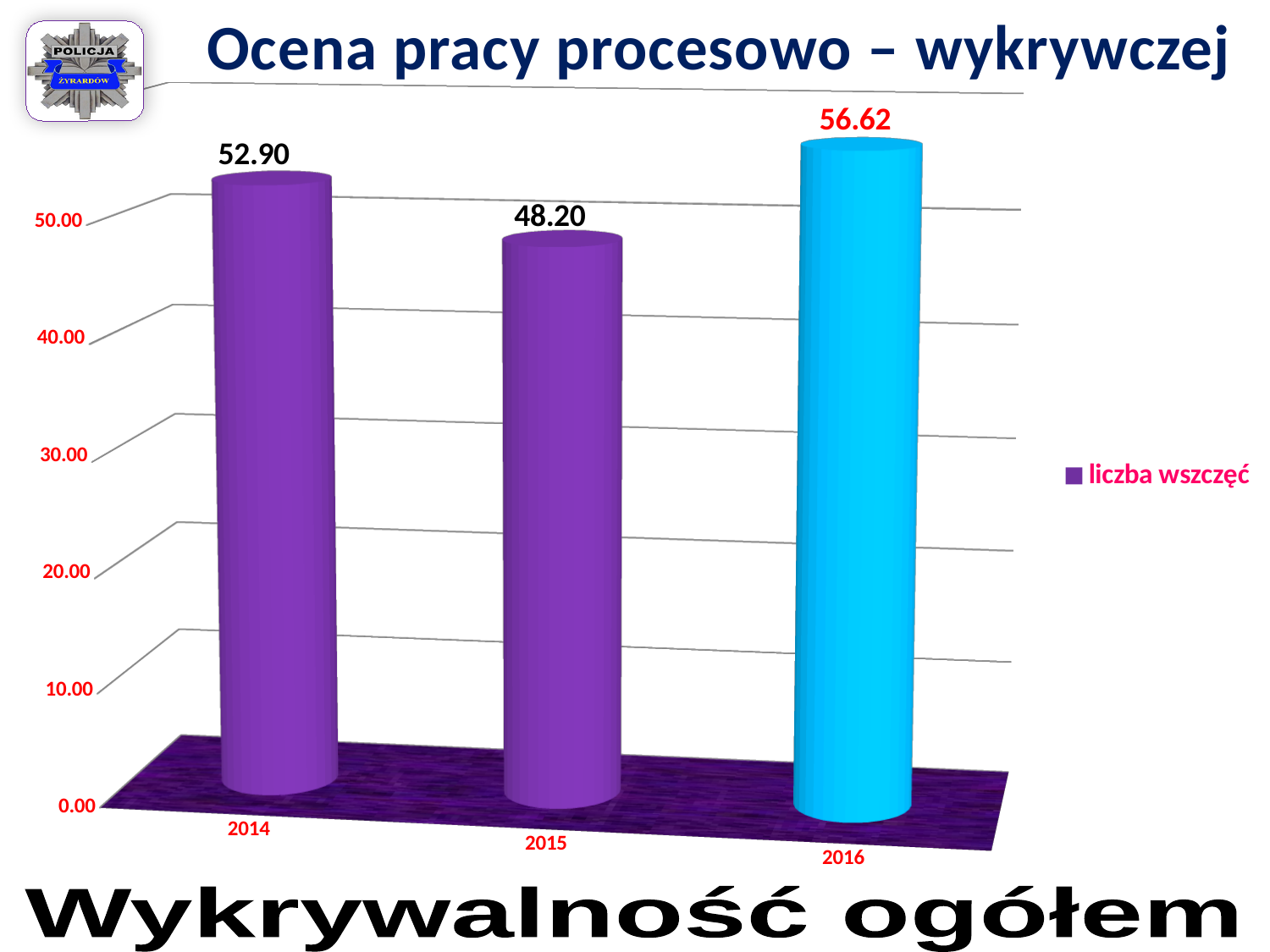
Which year has the highest value? 2016 Is the value for 2015 greater or less than 50.00? less Which is larger, the value for 2014 or the value for 2016? 2016 What is the value for 2016? 56.62 What is the value for 2014? 52.90 Which year has the lowest value? 2015 What is the difference between the values for 2014 and 2015? 4.70 What kind of chart is shown on the slide? bar chart What series name does the legend list? liczba wszczęć What is the value for 2015? 48.20 What is the difference between the values for 2016 and 2015? 8.42 How many years are shown on the chart? 3